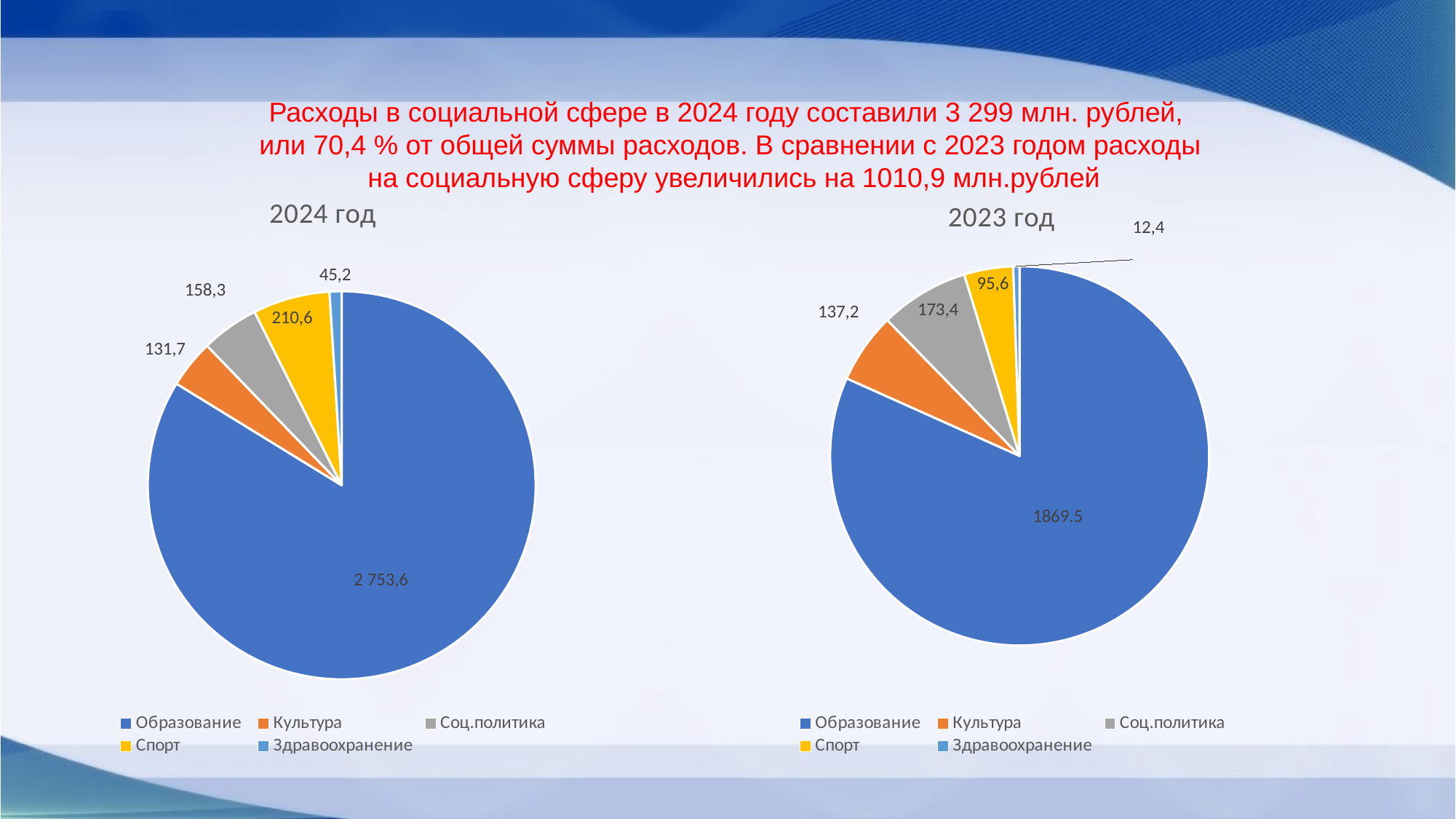
In the "2023 год" pie chart, what is the difference between the values for Соц.политика and Культура? 36,2 Is the value for Образование larger in the "2024 год" chart or the "2023 год" chart? 2024 год In the "2024 год" pie chart, what is the value for Спорт? 210,6 In the "2024 год" pie chart, what is the difference between the values for Спорт and Соц.политика? 52,3 In the "2023 год" pie chart, what is the value for Здравоохранение? 12,4 How many slices does the "2024 год" pie chart have? 5 In the "2023 год" pie chart, which category has the largest slice? Образование In the "2024 год" pie chart, what is the value for Образование? 2 753,6 In the "2024 год" chart, which colour represents Спорт in the legend? Yellow In the "2023 год" pie chart, what is the value for Соц.политика? 173,4 In the "2024 год" pie chart, which category has the smallest slice? Здравоохранение What type of chart is used for "2023 год"? Pie chart